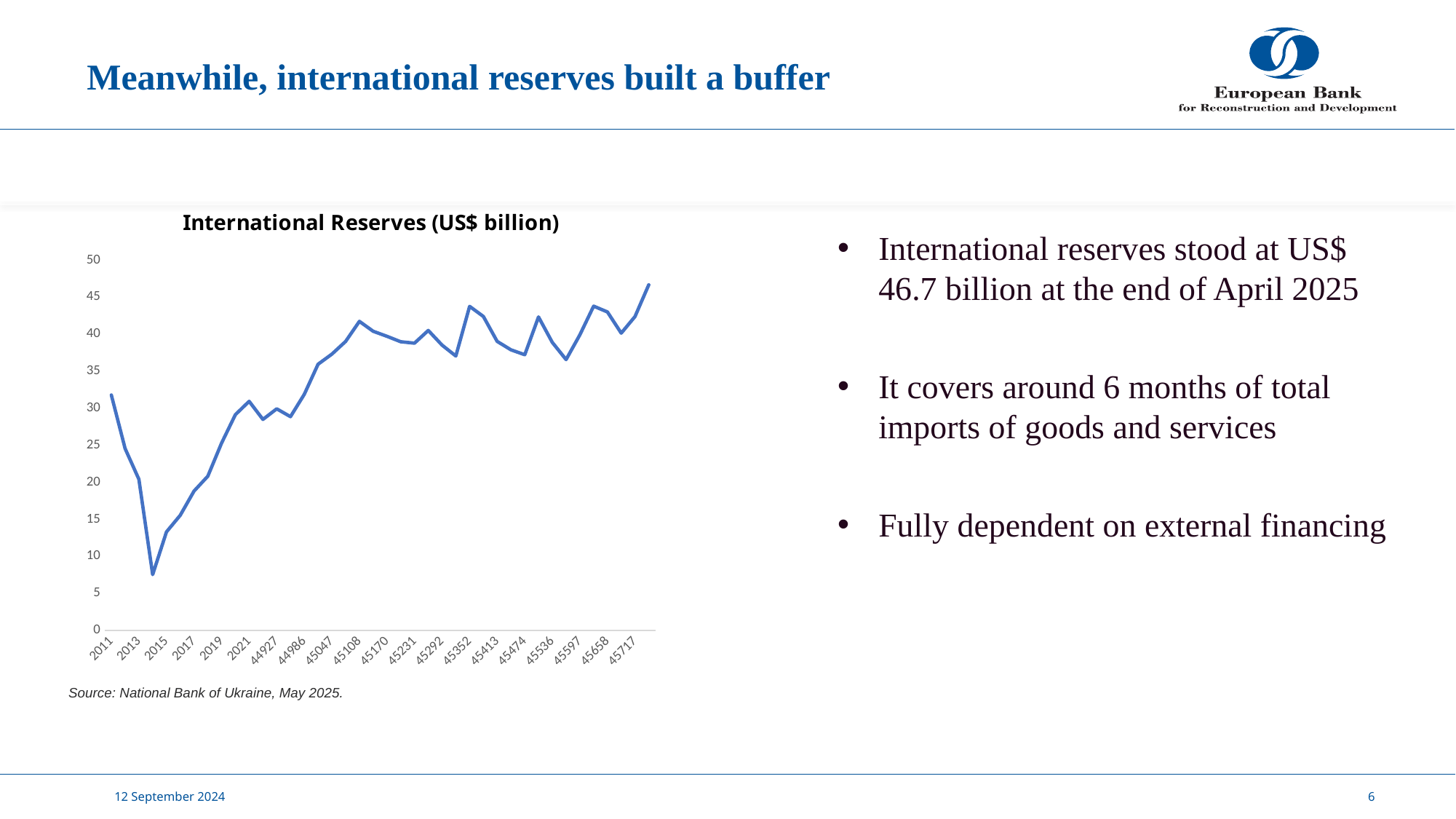
Is the value for 2015 greater or less than 10? greater Is the value for 45717 greater or less than 45? less Is the value for 45536 greater or less than 40? less What is the title of the chart? International Reserves (US$ billion) How many labels are shown on the x axis of the chart? 20 Which x-axis label has the lowest value on the chart? 2015 Which is larger, the value for 2011 or the value for 2015? 2011 What kind of chart is shown on the slide? line chart Does the line rise or fall between 2013 and 2015? fall